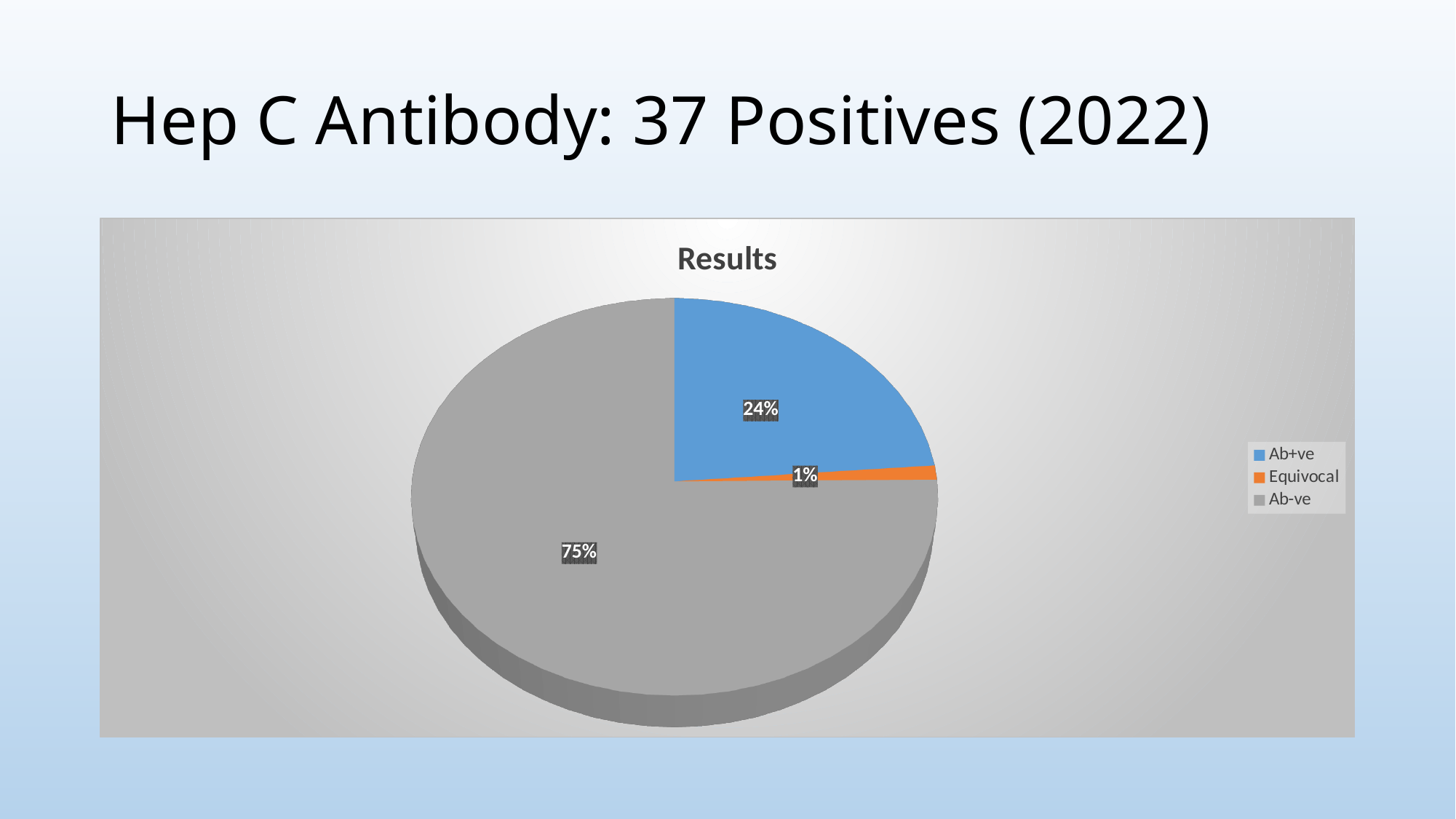
What type of chart is shown on the slide? pie chart Which category has the largest slice of the pie? Ab-ve What is the difference in percentage points between the Ab+ve and Equivocal slices? 23 What share of the pie is Equivocal? 1% Which is larger, the Ab+ve slice or the Equivocal slice? Ab+ve What is the chart's title? Results What share of the pie is Ab-ve? 75% Which category has the smallest slice of the pie? Equivocal How many categories does the pie chart show? 3 What is the difference in percentage points between the Ab-ve and Ab+ve slices? 51 What share of the pie is Ab+ve? 24% What colour is the Ab+ve slice? blue